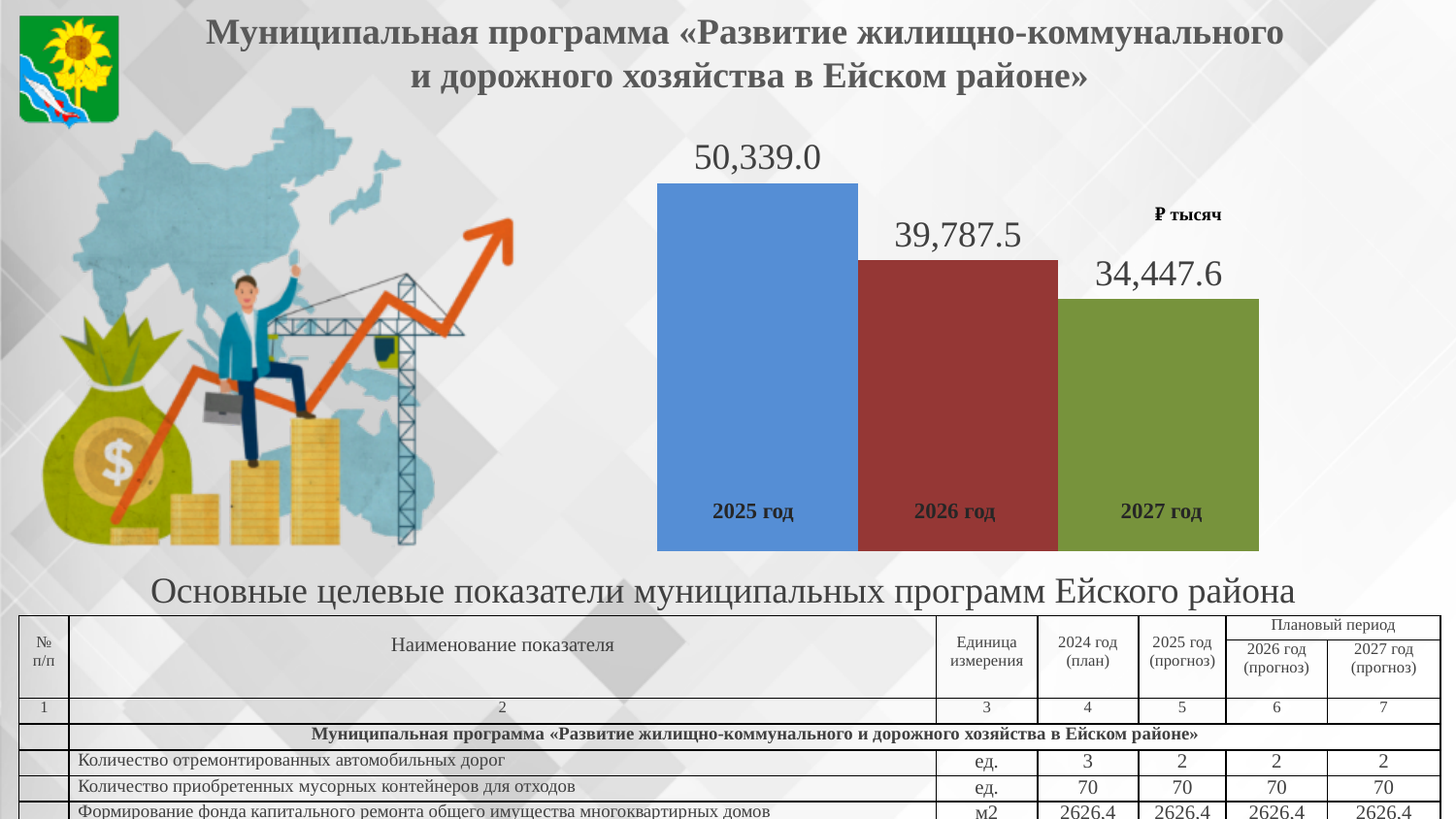
What type of chart is shown on the slide? bar chart Do the values rise or fall from 2025 год to 2027 год? fall Which year has the highest value in the chart? 2025 год How many bars are shown in the chart? 3 What is the difference between the values for 2026 год and 2027 год? 5,339.9 What is the difference between the values for 2025 год and 2026 год? 10,551.5 Which is larger, the value for 2026 год or the value for 2027 год? 2026 год What is the value shown for 2026 год? 39,787.5 Which year has the lowest value in the chart? 2027 год What is the value shown for 2025 год? 50,339.0 What is the value shown for 2027 год? 34,447.6 What is the difference between the values for 2025 год and 2027 год? 15,891.4